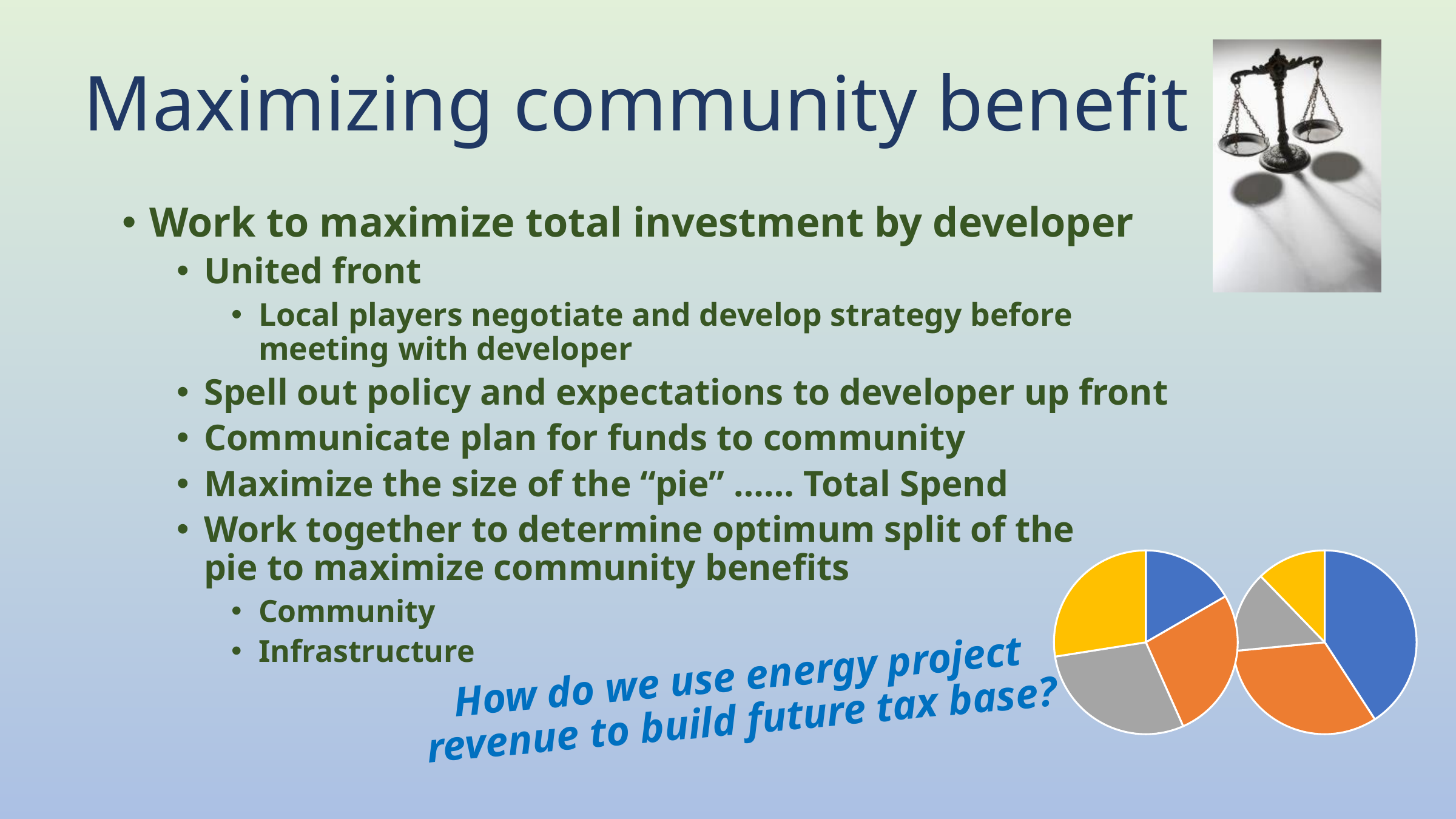
How many slices does the right pie chart at the bottom right of the slide have? 4 Do the pie charts on the slide have a legend? No In the right pie chart at the bottom right of the slide, which colour slice is the smallest? yellow In the left pie chart at the bottom right of the slide, which colour slice is the smallest? blue In the left pie chart at the bottom right of the slide, is the blue slice larger or smaller than the yellow slice? smaller In the right pie chart at the bottom right of the slide, is the blue slice larger or smaller than the gray slice? larger How many pie charts are shown on the slide? 2 What kind of chart is the chart on the left of the two at the bottom right of the slide? pie chart In the right pie chart at the bottom right of the slide, which colour slice is the largest? blue What kind of chart is the chart on the right of the two at the bottom right of the slide? pie chart What four colours are used for the slices in the pie charts on the slide? blue, orange, gray, yellow How many slices does the left pie chart at the bottom right of the slide have? 4